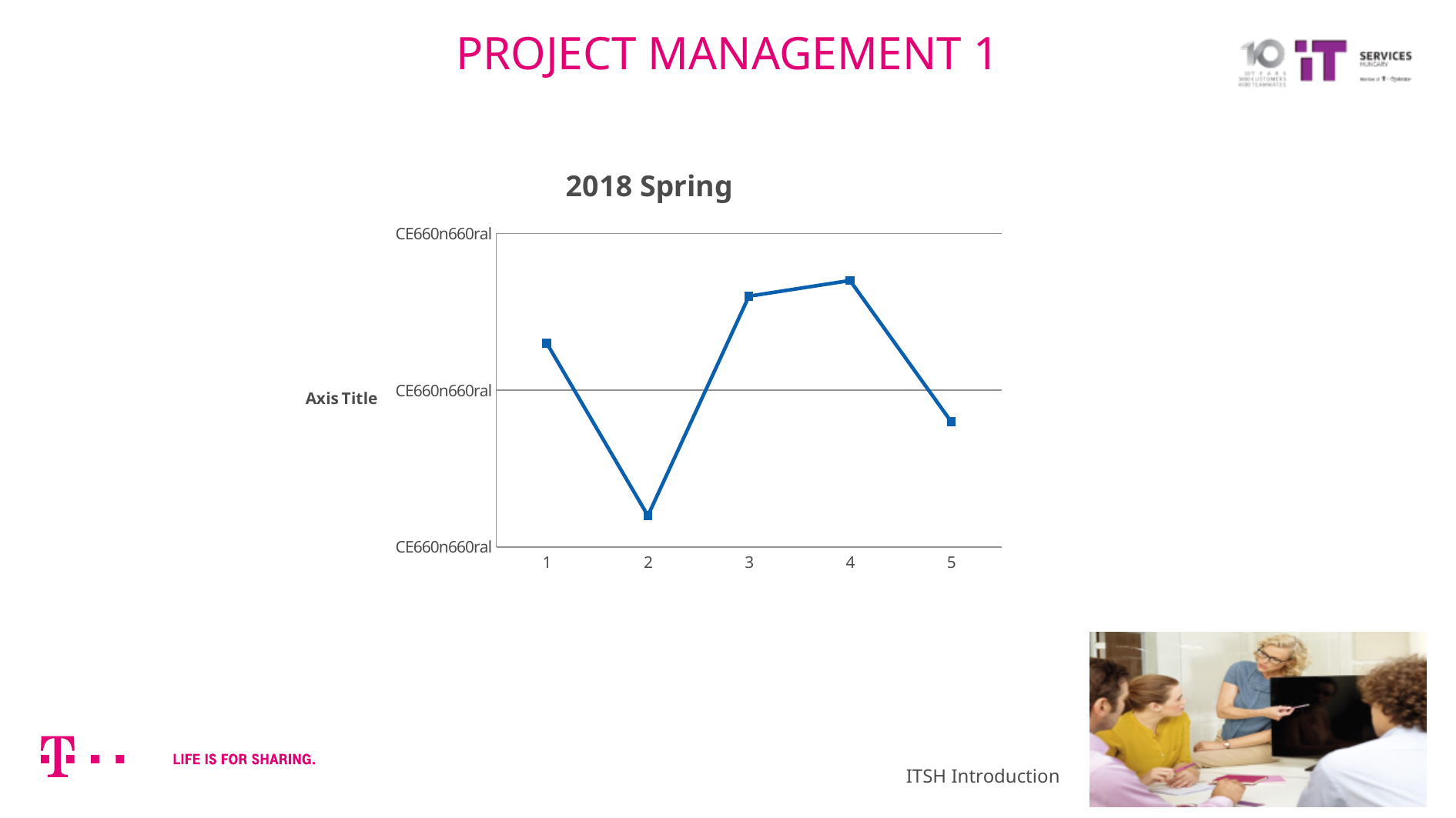
Does the line rise or fall from category 2 to category 3? rise Which has the larger value, category 1 or category 5? 1 Does the line rise or fall from category 1 to category 2? fall What kind of chart is shown on the slide? line chart Does the line rise or fall from category 4 to category 5? fall What text is shown as the vertical axis title? Axis Title Which category on the x axis has the lowest value? 2 Which has the larger value, category 2 or category 5? 5 Which category on the x axis has the highest value? 4 What is the title of the chart? 2018 Spring How many data points are plotted on the line? 5 Which has the larger value, category 3 or category 1? 3